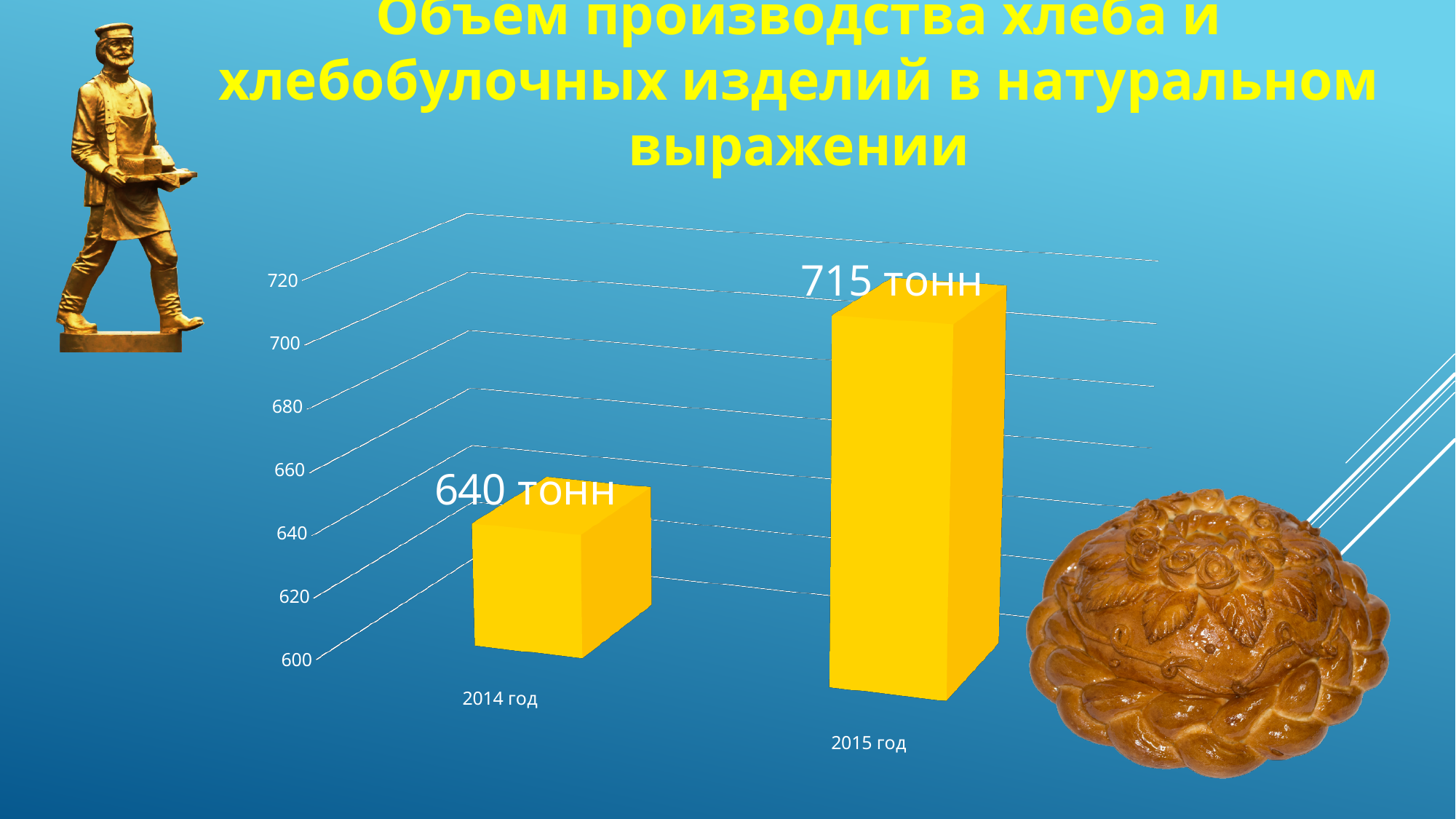
What is the difference between the values for 2015 год and 2014 год? 75 тонн Which year has the lowest value? 2014 год Is the value for 2014 год greater or less than 660? less What kind of chart is shown on the slide? bar chart Which year has the highest value? 2015 год Do the values rise or fall from 2014 год to 2015 год? rise Which is larger, the value for 2014 год or 2015 год? 2015 год What is the title of the slide? Объем производства хлеба и хлебобулочных изделий в натуральном выражении How many categories are shown on the chart? 2 What is the value for 2014 год? 640 тонн Is the value for 2015 год greater or less than 700? greater What is the value for 2015 год? 715 тонн